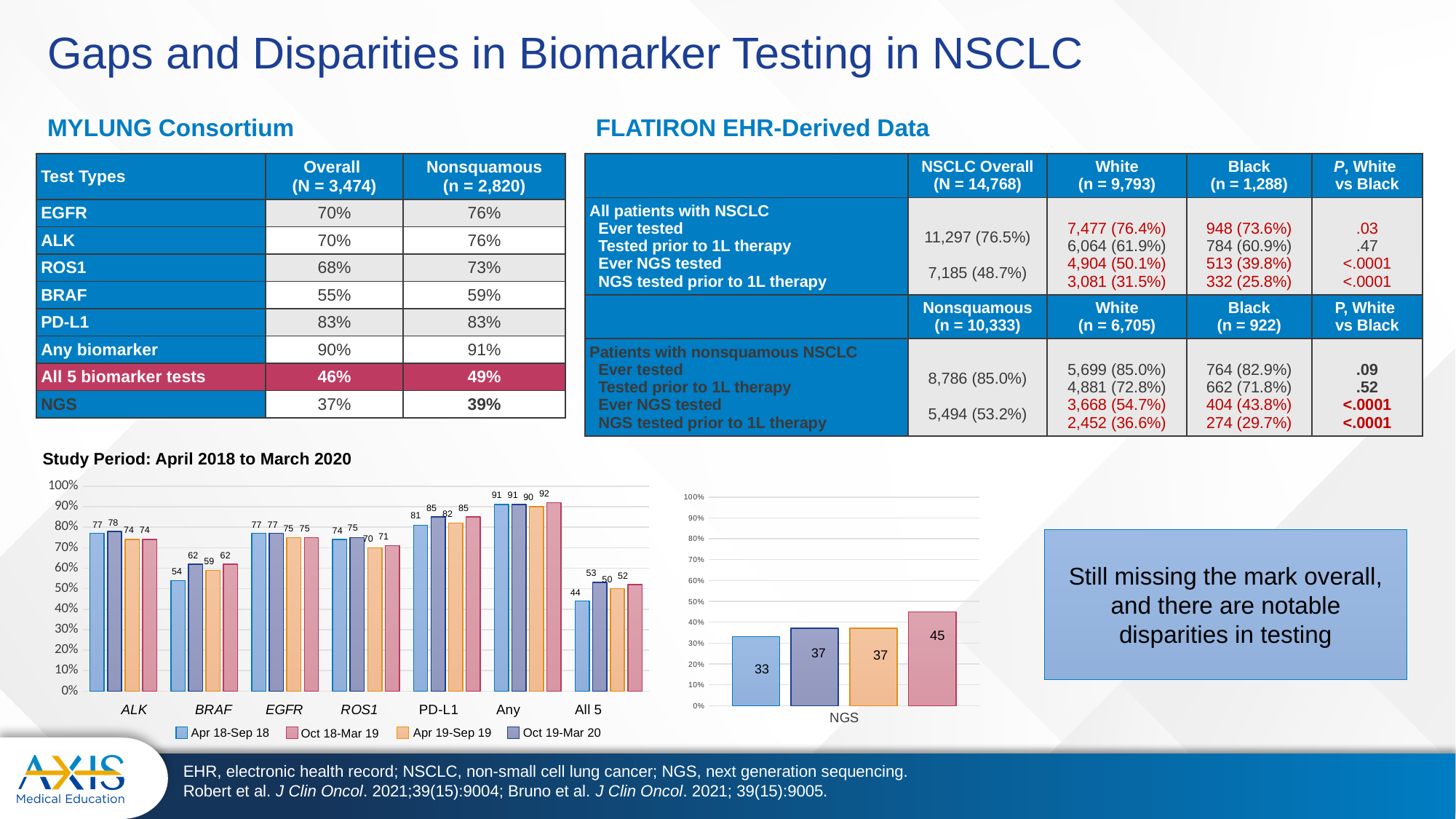
In the left bar chart (Study Period: April 2018 to March 2020), is the Apr 18-Sep 18 value for BRAF greater or less than 50%? greater In the left bar chart (Study Period: April 2018 to March 2020), which is larger for Apr 19-Sep 19: EGFR or ROS1? EGFR In the left bar chart (Study Period: April 2018 to March 2020), what is the Apr 19-Sep 19 value for BRAF? 59 In the left bar chart (Study Period: April 2018 to March 2020), which category has the lowest Apr 18-Sep 18 value? All 5 In the left bar chart (Study Period: April 2018 to March 2020), which category has the highest values across all periods? Any What kind of chart is the left chart under 'Study Period: April 2018 to March 2020'? bar chart In the NGS bar chart on the right, what is the value of the leftmost bar? 33 In the left bar chart (Study Period: April 2018 to March 2020), what is the difference between the Apr 18-Sep 18 values for ALK and All 5? 33 In the left bar chart (Study Period: April 2018 to March 2020), what is the Apr 18-Sep 18 value for All 5? 44 In the left bar chart (Study Period: April 2018 to March 2020), how many series does the legend list? 4 In the NGS bar chart on the right, what is the value of the tallest bar? 45 In the left bar chart (Study Period: April 2018 to March 2020), how many biomarker categories are shown on the x axis? 7